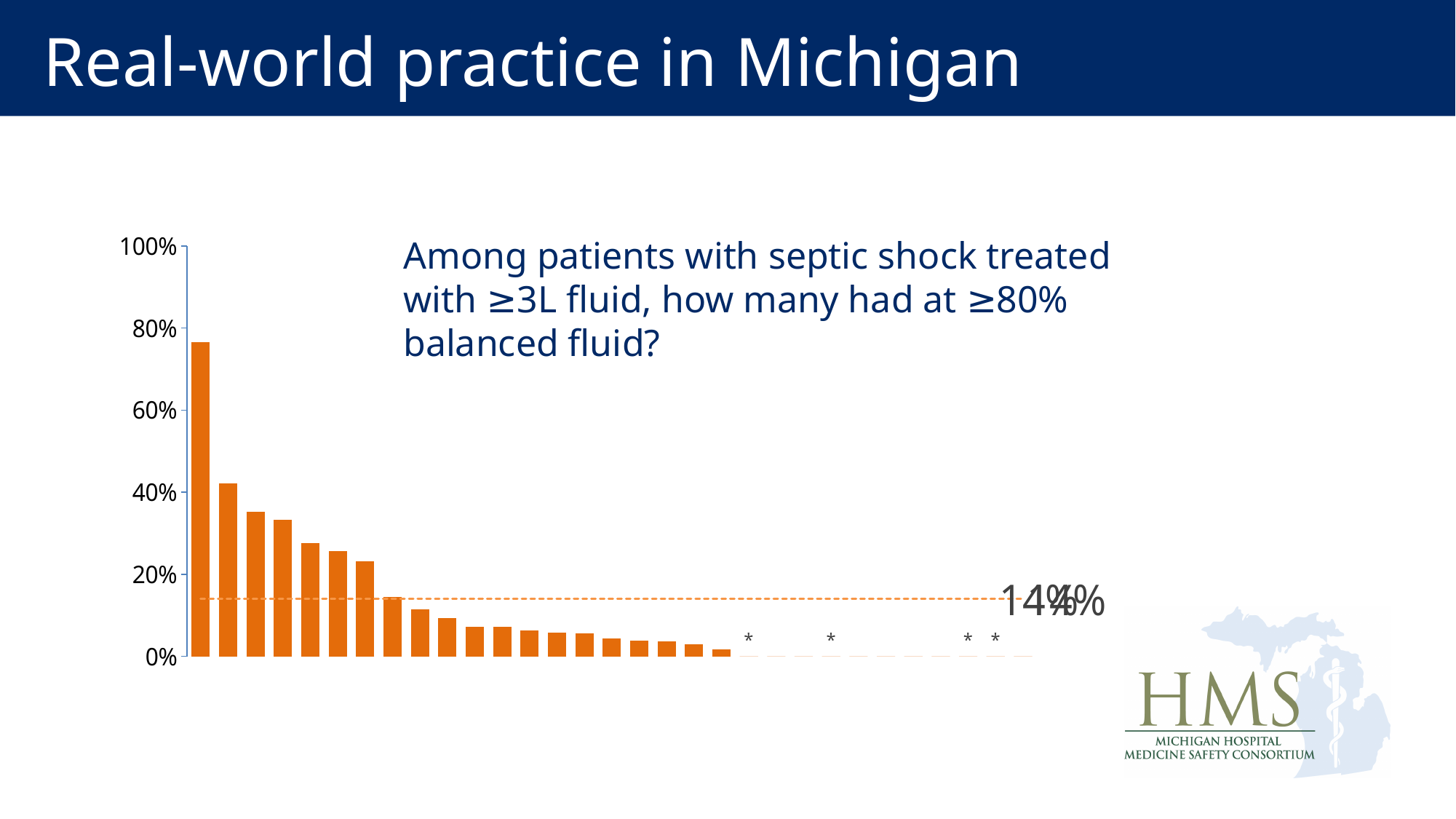
What colour are the bars in the chart? orange Is the value of the tallest (leftmost) bar greater or less than 60%? greater What is the highest value shown on the y-axis? 100% Is the value of the tallest (leftmost) bar greater or less than 80%? less Do the bar values rise or fall from left to right across the chart? fall Is the value of the rightmost bar greater or less than 20%? less How many bars are plotted in the chart? 20 What value is printed next to the dashed horizontal line on the chart? 14% What kind of chart is shown on the slide? bar chart